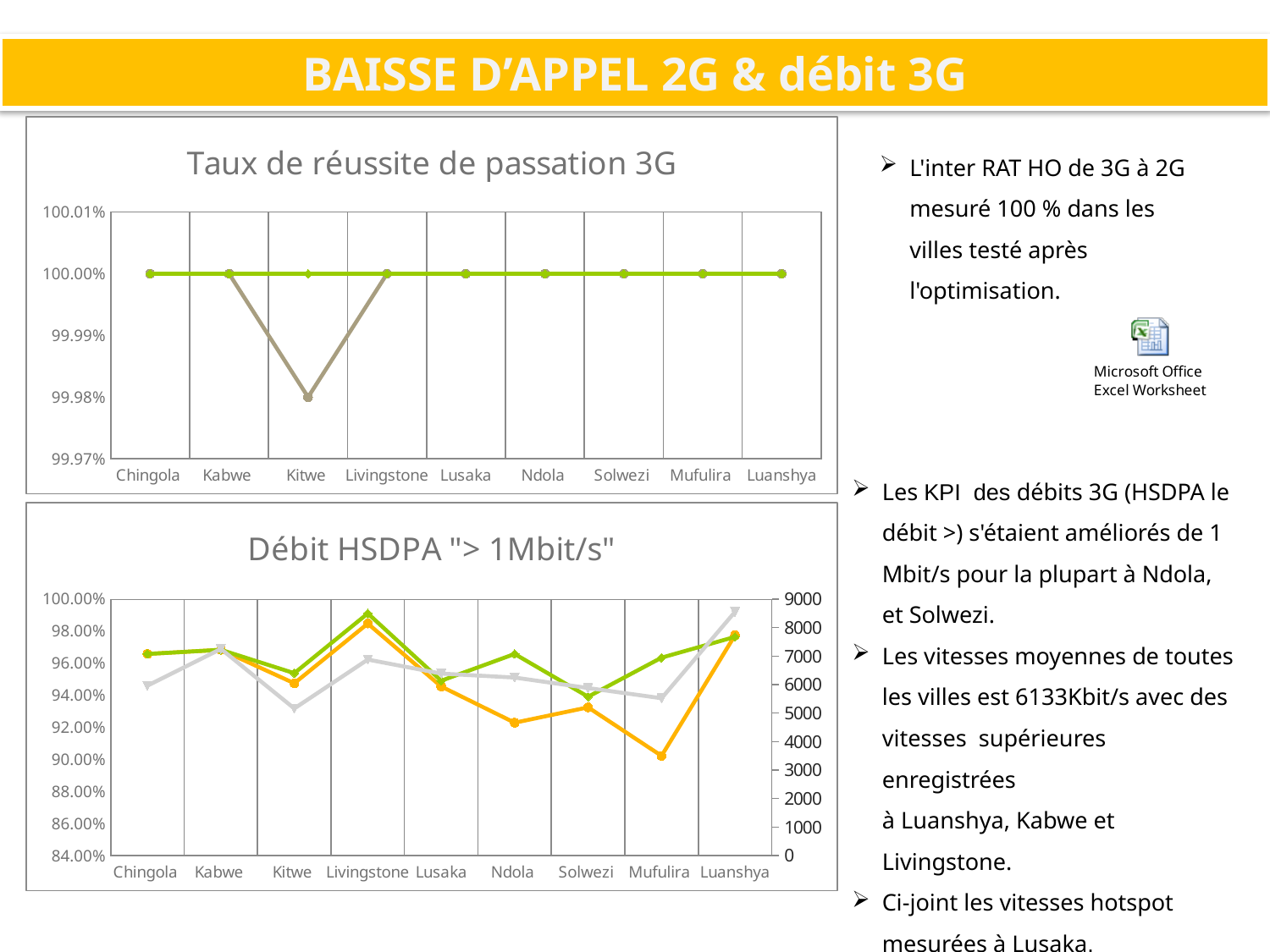
How many cities are listed on the x axis of the 'Débit HSDPA "> 1Mbit/s"' chart? 9 In the 'Taux de réussite de passation 3G' chart, at which city does the lower (grey) line dip below 100.00%? Kitwe How many cities are shown on the x axis of the 'Taux de réussite de passation 3G' chart? 9 In the 'Débit HSDPA "> 1Mbit/s"' chart, at which city is the orange line at its lowest? Mufulira In the 'Débit HSDPA "> 1Mbit/s"' chart, is the value of the orange line at Mufulira greater or less than 92.00%? less In the 'Taux de réussite de passation 3G' chart, what is the value of the green line at Chingola? 100.00% What is the title of the lower chart on the slide? Débit HSDPA "> 1Mbit/s" What kind of chart is the 'Taux de réussite de passation 3G' chart? line chart What kind of chart is the 'Débit HSDPA "> 1Mbit/s"' chart? line chart In the 'Débit HSDPA "> 1Mbit/s"' chart, is the value of the green line at Livingstone greater or less than 98.00%? greater In the 'Taux de réussite de passation 3G' chart, does the green line rise, fall or stay flat across the cities? stays flat In the 'Taux de réussite de passation 3G' chart, what value does the grey line reach at Kitwe? 99.98%